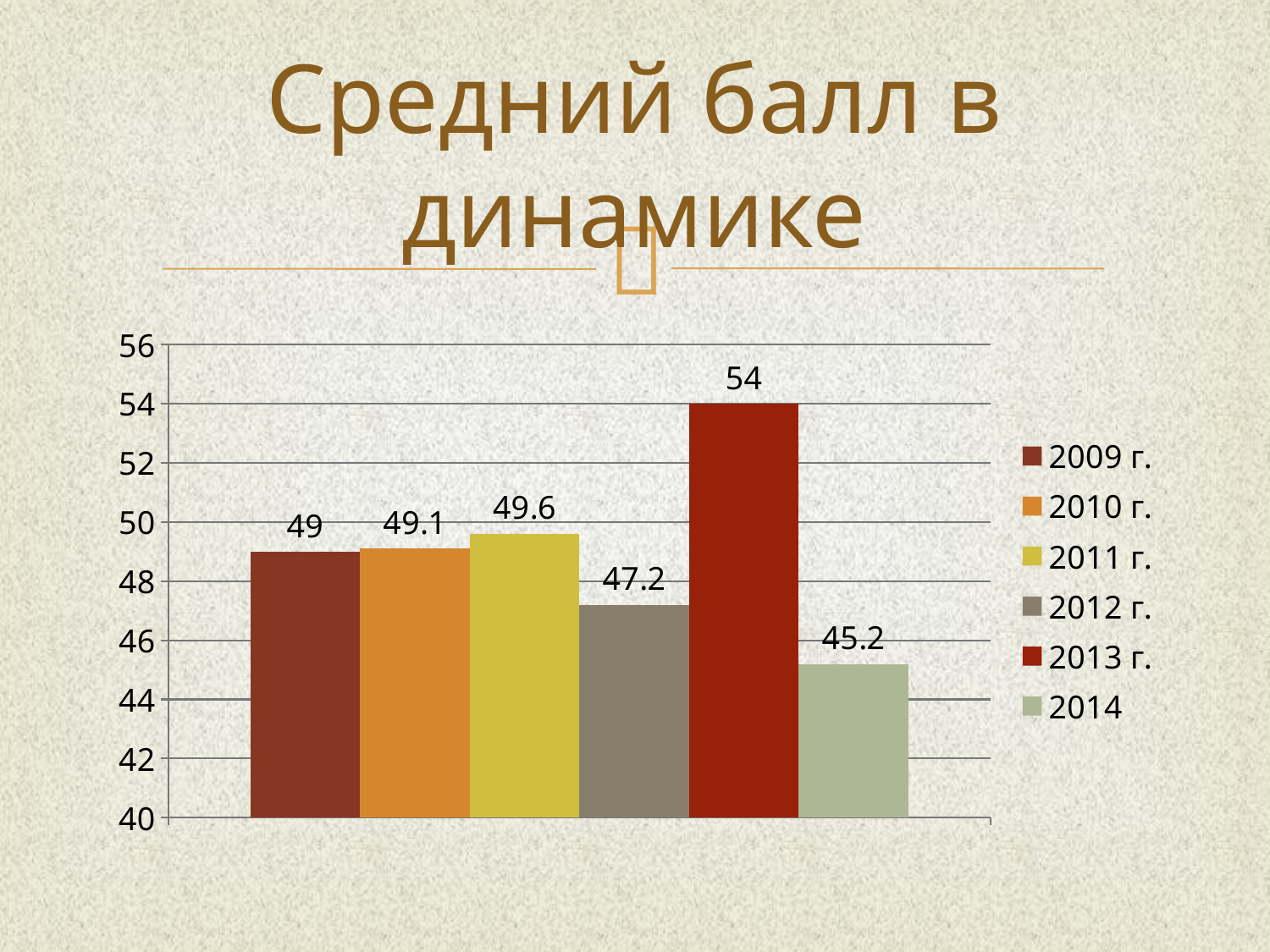
Which year has the lowest value? 2014 Which is larger, the value for 2011 г. or the value for 2012 г.? 2011 г. Which year has the highest value? 2013 г. What is the title of the chart on the slide? Средний балл в динамике What is the value for 2013 г.? 54 What is the difference between the values for 2011 г. and 2012 г.? 2.4 What is the value for 2009 г.? 49 What is the difference between the values for 2013 г. and 2014? 8.8 What is the value for 2014? 45.2 How many series does the legend list? 6 What kind of chart is shown on the slide? bar chart What is the value for 2012 г.? 47.2